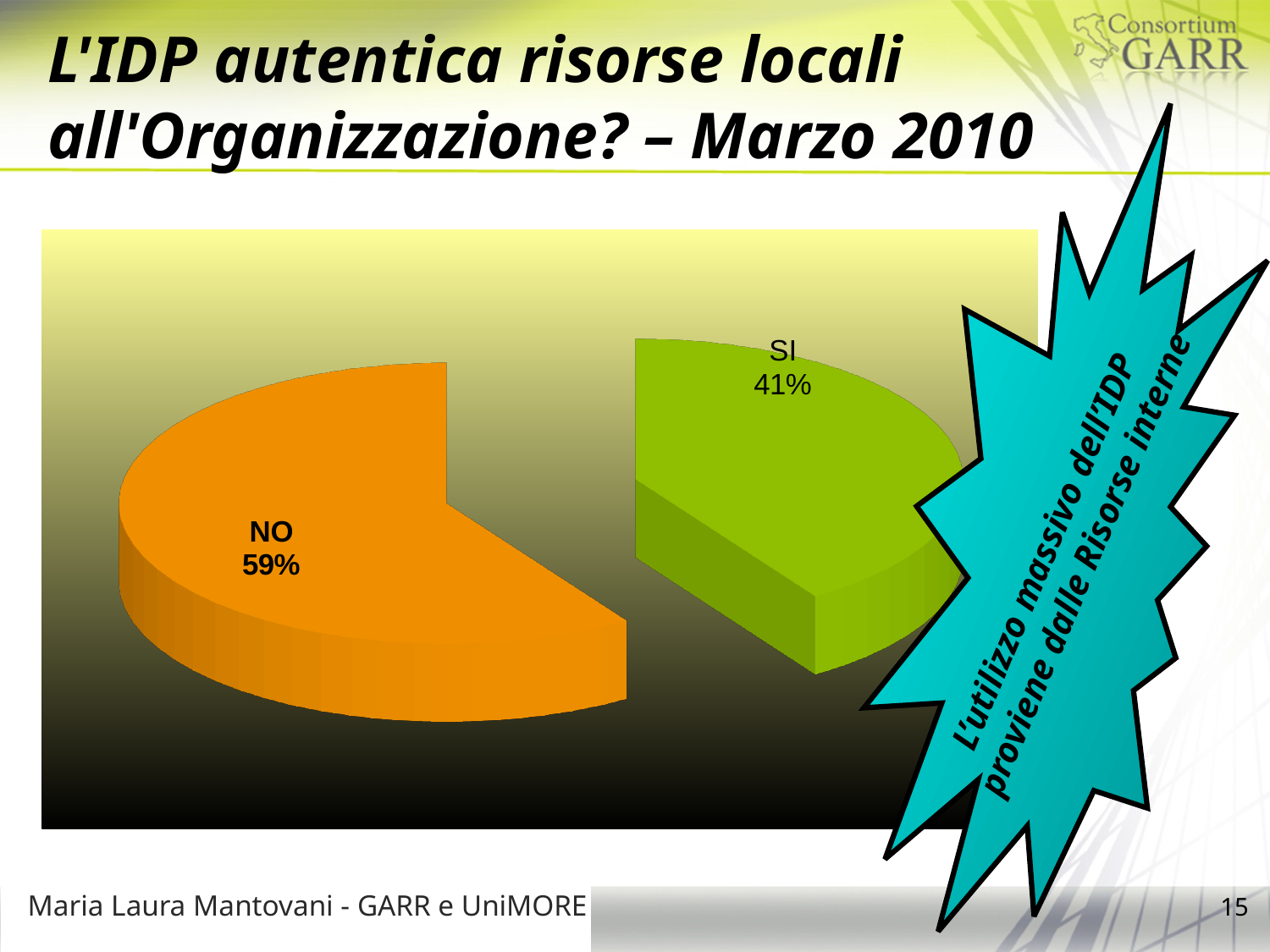
What percentage is shown for the SI slice? 41% What kind of chart is shown on the slide? pie chart Which slice is the smallest in the pie chart? SI What is the difference in percentage points between the NO and SI slices? 18 What colour is the SI slice? green What share of the pie does the SI slice represent? 41% Which slice is the largest in the pie chart? NO Which slice is larger, SI or NO? NO What colour is the NO slice? orange What percentage is shown for the NO slice? 59% How many slices does the pie chart have? 2